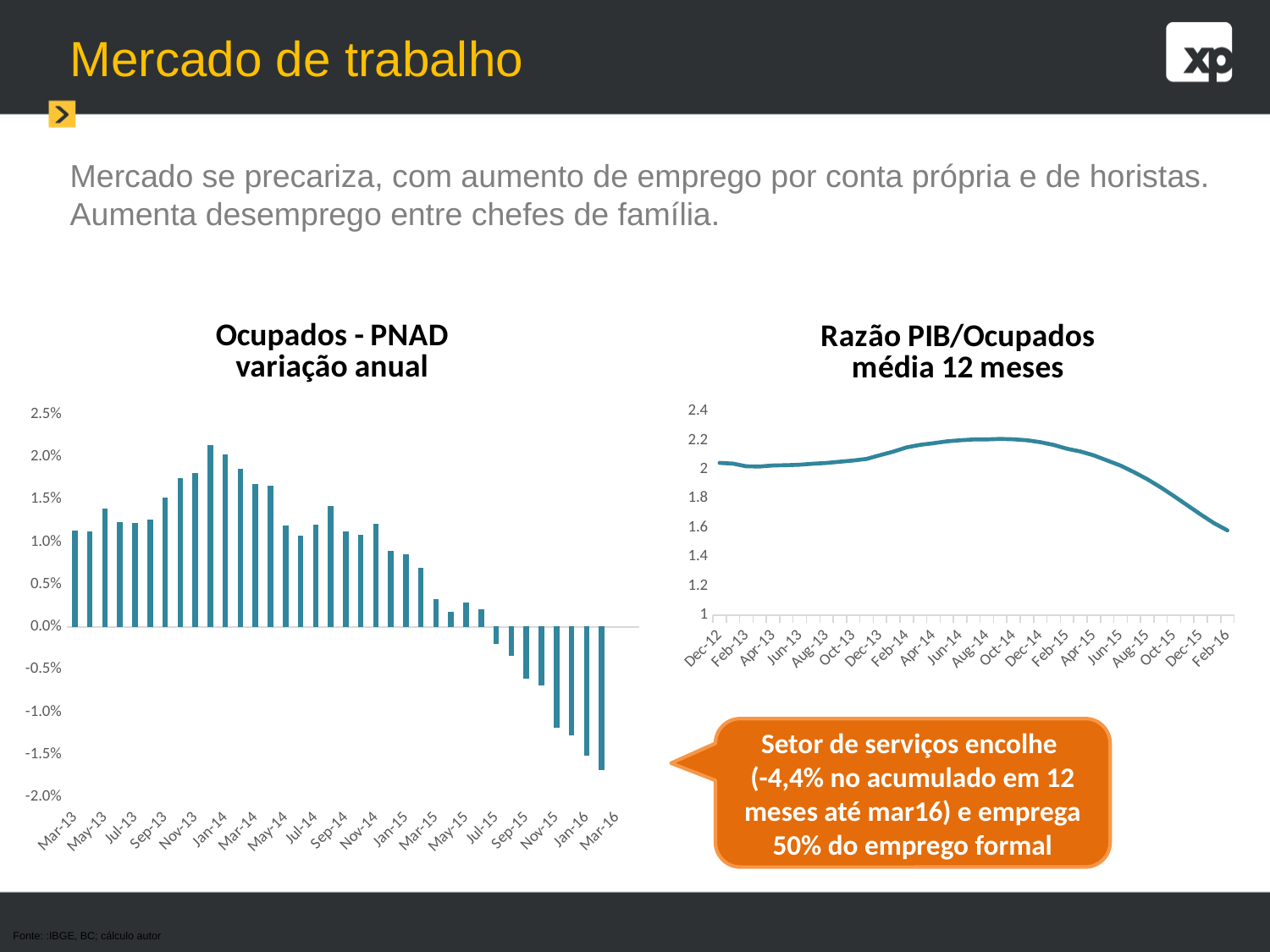
In the "Ocupados - PNAD variação anual" chart, is the value for Mar-13 greater or less than 0.5%? greater In the "Ocupados - PNAD variação anual" chart, do the values generally rise or fall from Mar-13 to Mar-16? fall In the "Ocupados - PNAD variação anual" chart, which month has the highest value? Dec-13 In the "Razão PIB/Ocupados média 12 meses" chart, is the value for Feb-16 greater or less than 1.8? less In the "Razão PIB/Ocupados média 12 meses" chart, is the value for Dec-12 greater or less than 1.8? greater In the "Razão PIB/Ocupados média 12 meses" chart, which is larger, the value for Oct-14 or the value for Feb-16? Oct-14 In the "Ocupados - PNAD variação anual" chart, which month has the lowest value? Feb-16 What kind of chart is "Ocupados - PNAD variação anual"? bar chart How many charts are shown on the slide? 2 What kind of chart is "Razão PIB/Ocupados média 12 meses"? line chart